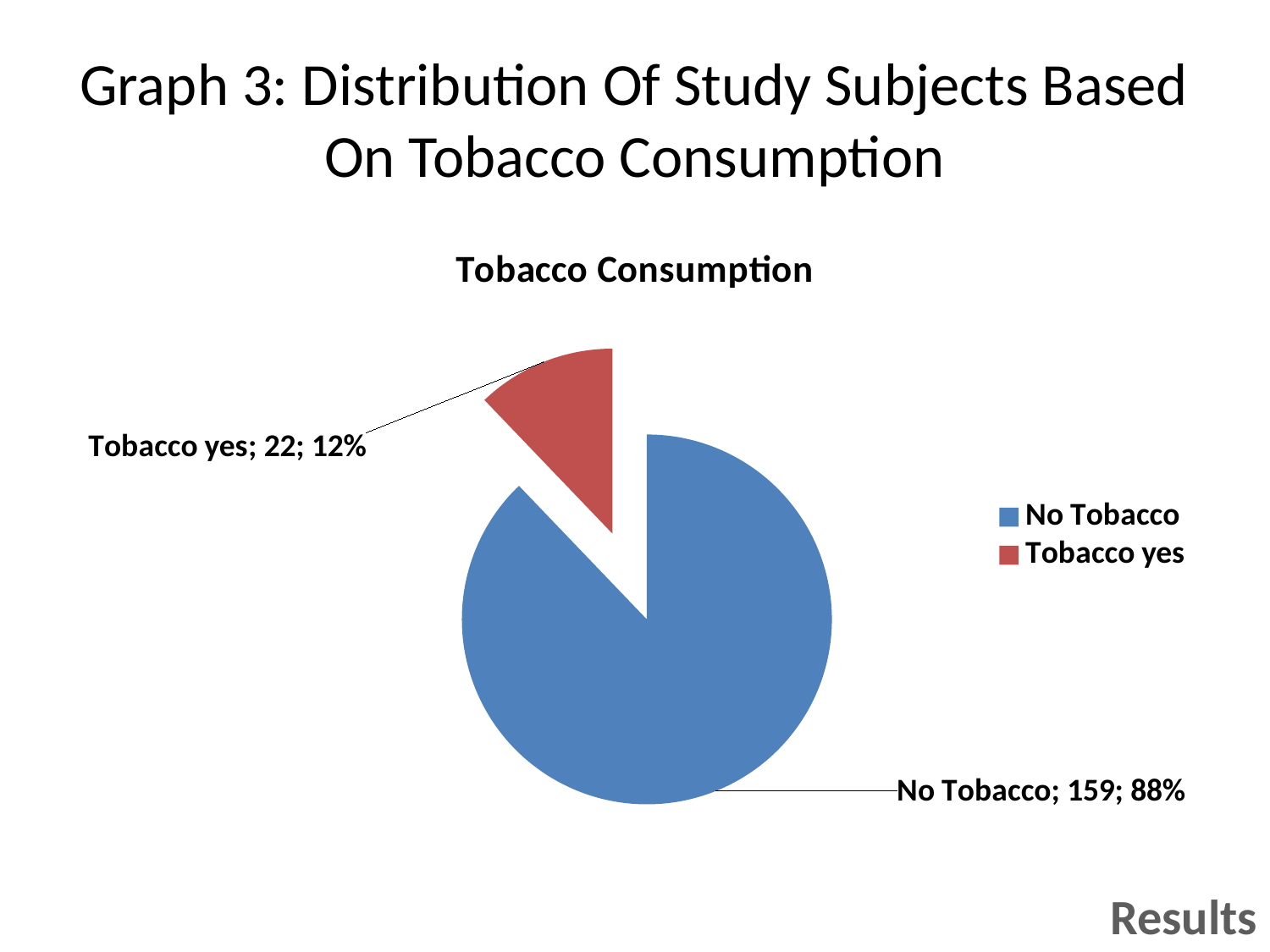
Which category has the largest slice? No Tobacco How many entries does the legend list? 2 How many slices does the pie chart have? 2 What kind of chart is shown on the slide? pie chart What share of the pie does the Tobacco yes slice represent? 12% What is the total number of study subjects across both slices? 181 What share of the pie does the No Tobacco slice represent? 88% What is the title of the chart? Tobacco Consumption What is the difference between the No Tobacco and Tobacco yes counts? 137 What is the value for Tobacco yes? 22 What is the value for No Tobacco? 159 Which category has the smallest slice? Tobacco yes